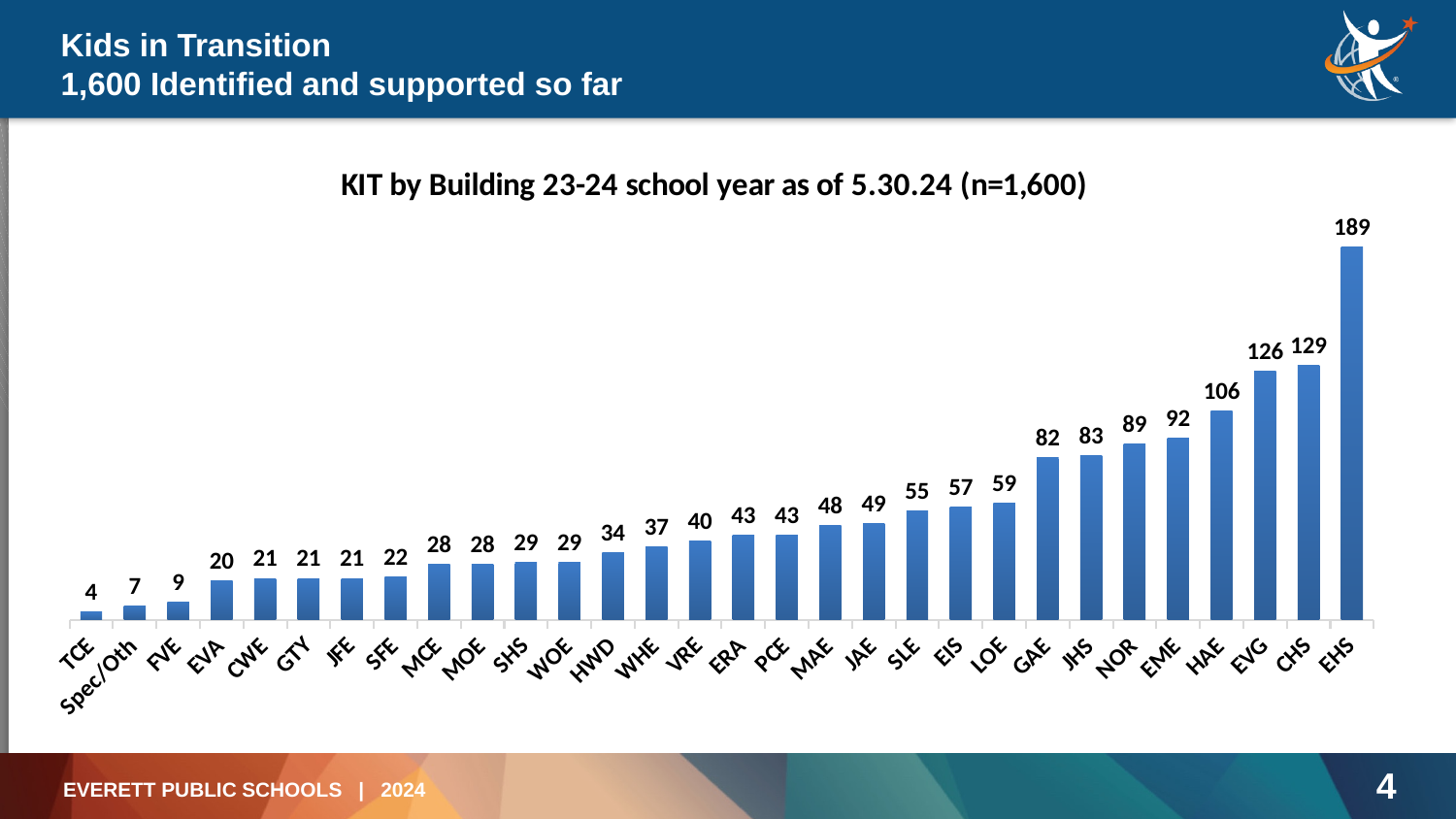
Which building has the highest value? EHS What is the value for WHE? 37 Do the values rise or fall from left to right along the x axis? Rise What is the difference between the values for GAE and LOE? 23 Which building has the lowest value? TCE What is the difference between the values for EHS and CHS? 60 What is the value for Spec/Oth? 7 What kind of chart is shown on the slide? Bar chart How many buildings are shown on the x axis? 30 Which is larger, the value for EVG or the value for HAE? EVG What is the value for EHS? 189 What is the value for HAE? 106